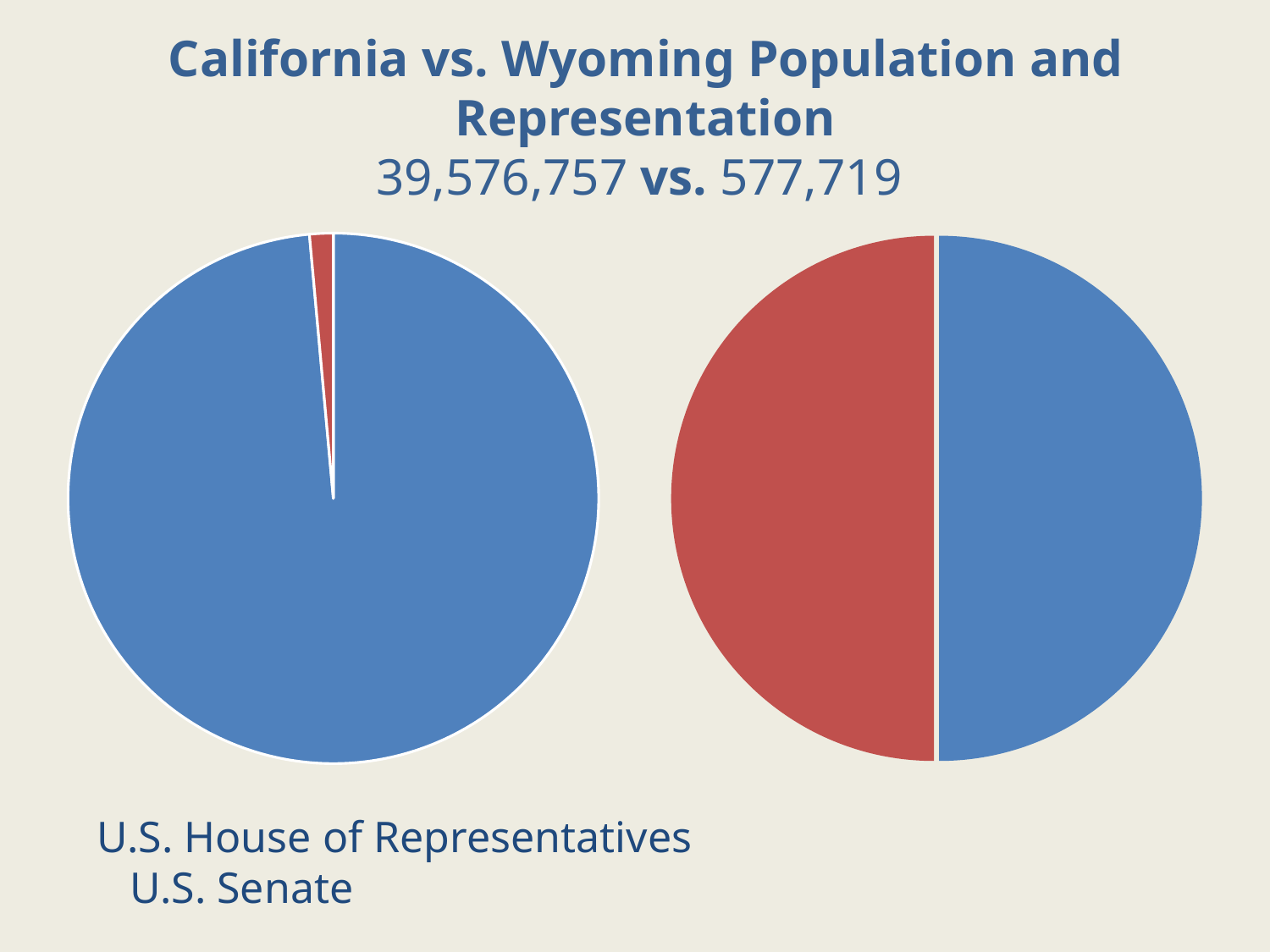
How many slices does the pie chart on the left of the slide have? 2 What kind of chart is the chart on the left of the slide? pie chart How many charts are shown on the slide? 2 In the pie chart on the right of the slide, do the red and blue slices appear roughly equal in size? yes In the pie chart on the left of the slide, which slice is larger, the blue slice or the red slice? the blue slice What colour is the smaller slice in the pie chart on the left of the slide? red What kind of chart is the chart on the right of the slide? pie chart How many slices does the pie chart on the right of the slide have? 2 What is the title shown above the charts on the slide? California vs. Wyoming Population and Representation